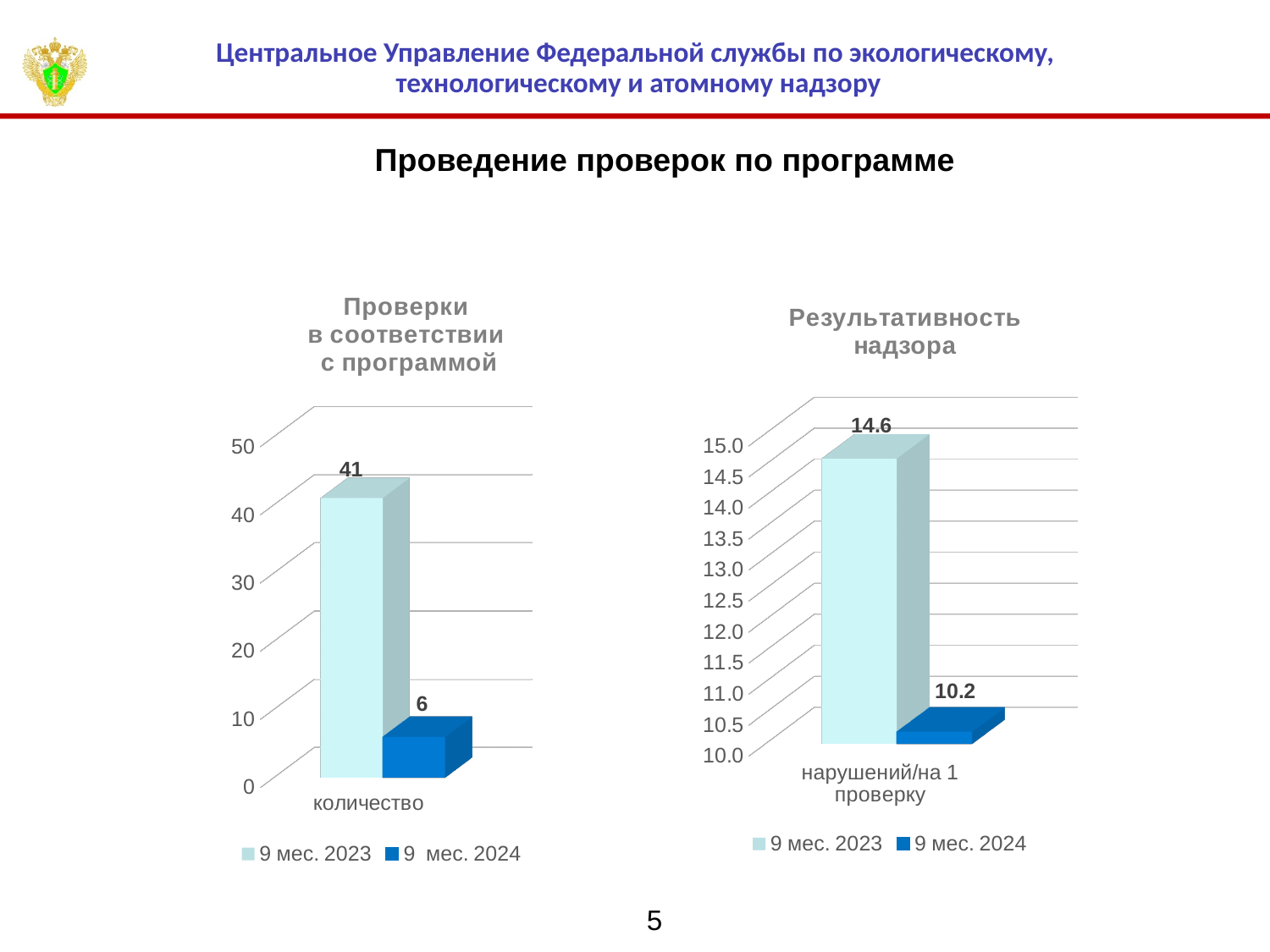
In the chart titled "Результативность надзора", what is the category label on the x axis? нарушений/на 1 проверку In the chart titled "Проверки в соответствии с программой", which series has the larger value, "9 мес. 2023" or "9 мес. 2024"? 9 мес. 2023 In the chart titled "Результативность надзора", what is the difference between the values for "9 мес. 2023" and "9 мес. 2024"? 4.4 In the chart titled "Проверки в соответствии с программой", what is the difference between the values for "9 мес. 2023" and "9 мес. 2024"? 35 In the chart titled "Результативность надзора", what is the value for "9 мес. 2023"? 14.6 In the chart titled "Проверки в соответствии с программой", what is the category label on the x axis? количество In the chart titled "Результативность надзора", which series has the lower value? 9 мес. 2024 In the chart titled "Результативность надзора", what is the value for "9 мес. 2024"? 10.2 What kind of chart is the chart titled "Проверки в соответствии с программой"? bar chart In the chart titled "Проверки в соответствии с программой", what is the value for "9 мес. 2023"? 41 In the chart titled "Результативность надзора", how many series does the legend list? 2 In the chart titled "Проверки в соответствии с программой", what is the value for "9 мес. 2024"? 6